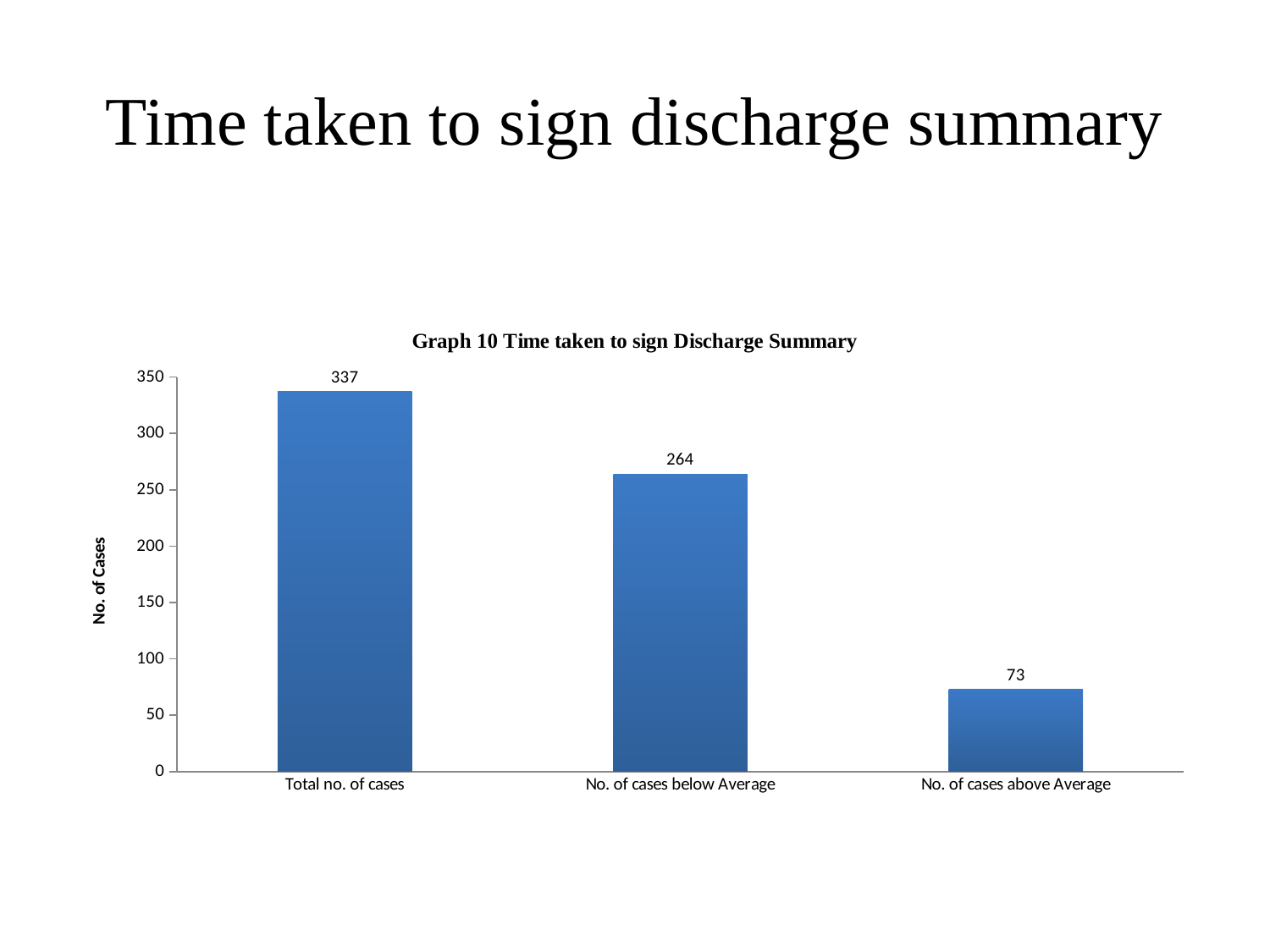
What is the difference between No. of cases below Average and No. of cases above Average? 191 What kind of chart is shown? bar chart What is the value for No. of cases above Average? 73 Which category has the highest value? Total no. of cases What is the title of the chart? Graph 10 Time taken to sign Discharge Summary How many categories are shown on the x axis? 3 What is the value for No. of cases below Average? 264 What is the value for Total no. of cases? 337 Is the value for No. of cases above Average greater or less than 100? less Which is larger, No. of cases below Average or No. of cases above Average? No. of cases below Average Which category has the lowest value? No. of cases above Average What is the difference between Total no. of cases and No. of cases below Average? 73